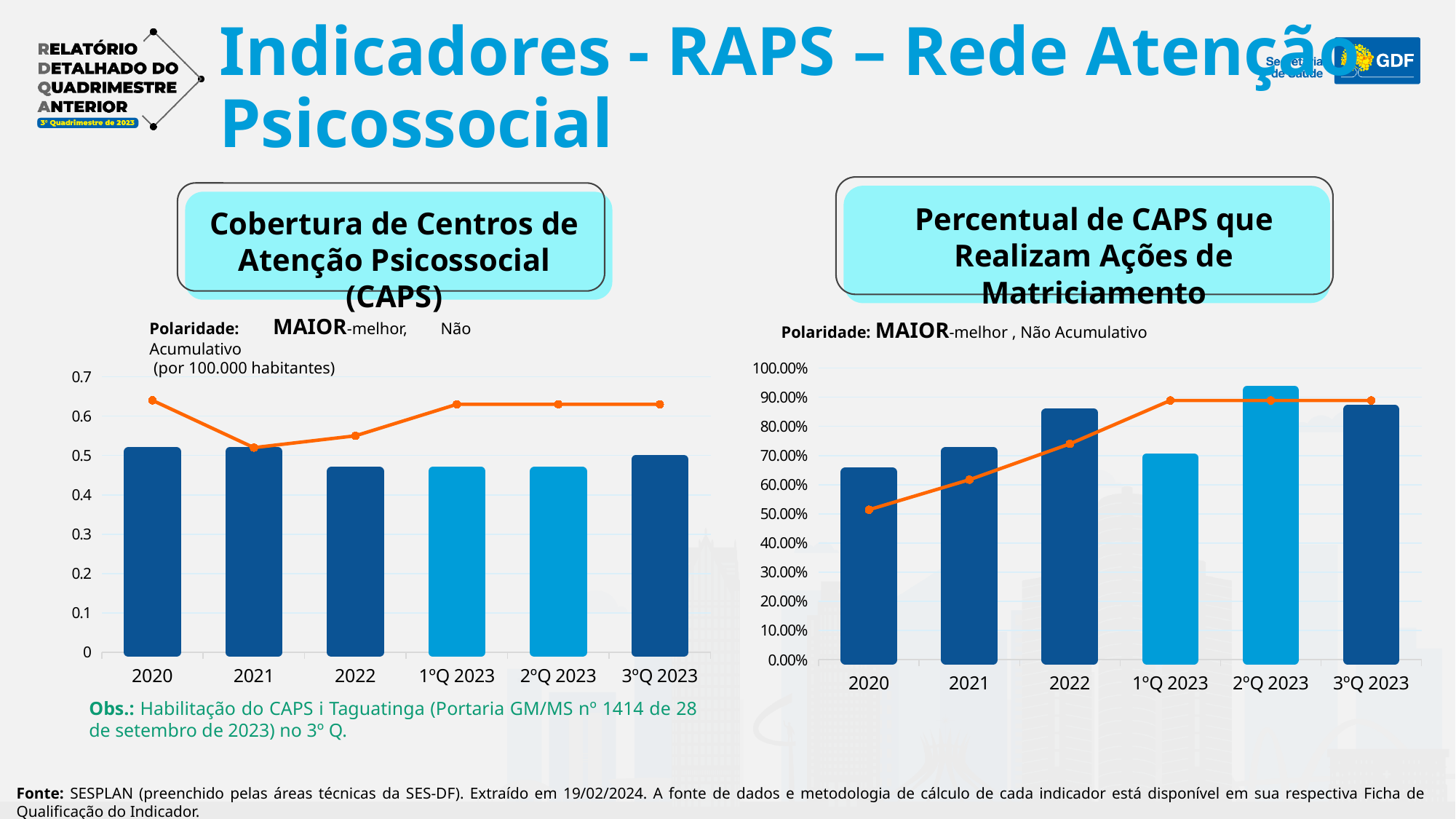
In the 'Percentual de CAPS que Realizam Ações de Matriciamento' chart, is the bar for 2022 greater or less than 80.00%? greater In the 'Percentual de CAPS que Realizam Ações de Matriciamento' chart, which is larger, the bar for 2022 or the bar for 1ºQ 2023? 2022 In the 'Percentual de CAPS que Realizam Ações de Matriciamento' chart, which category has the highest bar? 2ºQ 2023 In the 'Cobertura de Centros de Atenção Psicossocial (CAPS)' chart, is the bar for 2022 greater or less than 0.5? less In the 'Percentual de CAPS que Realizam Ações de Matriciamento' chart, which category has the lowest bar? 2020 In the 'Cobertura de Centros de Atenção Psicossocial (CAPS)' chart, is the bar for 2020 greater or less than 0.5? greater In the 'Cobertura de Centros de Atenção Psicossocial (CAPS)' chart, which is larger, the bar for 2021 or the bar for 2022? 2021 What kind of chart is the 'Cobertura de Centros de Atenção Psicossocial (CAPS)' chart? Bar chart with a line How many categories are shown on the x axis of the 'Percentual de CAPS que Realizam Ações de Matriciamento' chart? 6 How many categories are shown on the x axis of the 'Cobertura de Centros de Atenção Psicossocial (CAPS)' chart? 6